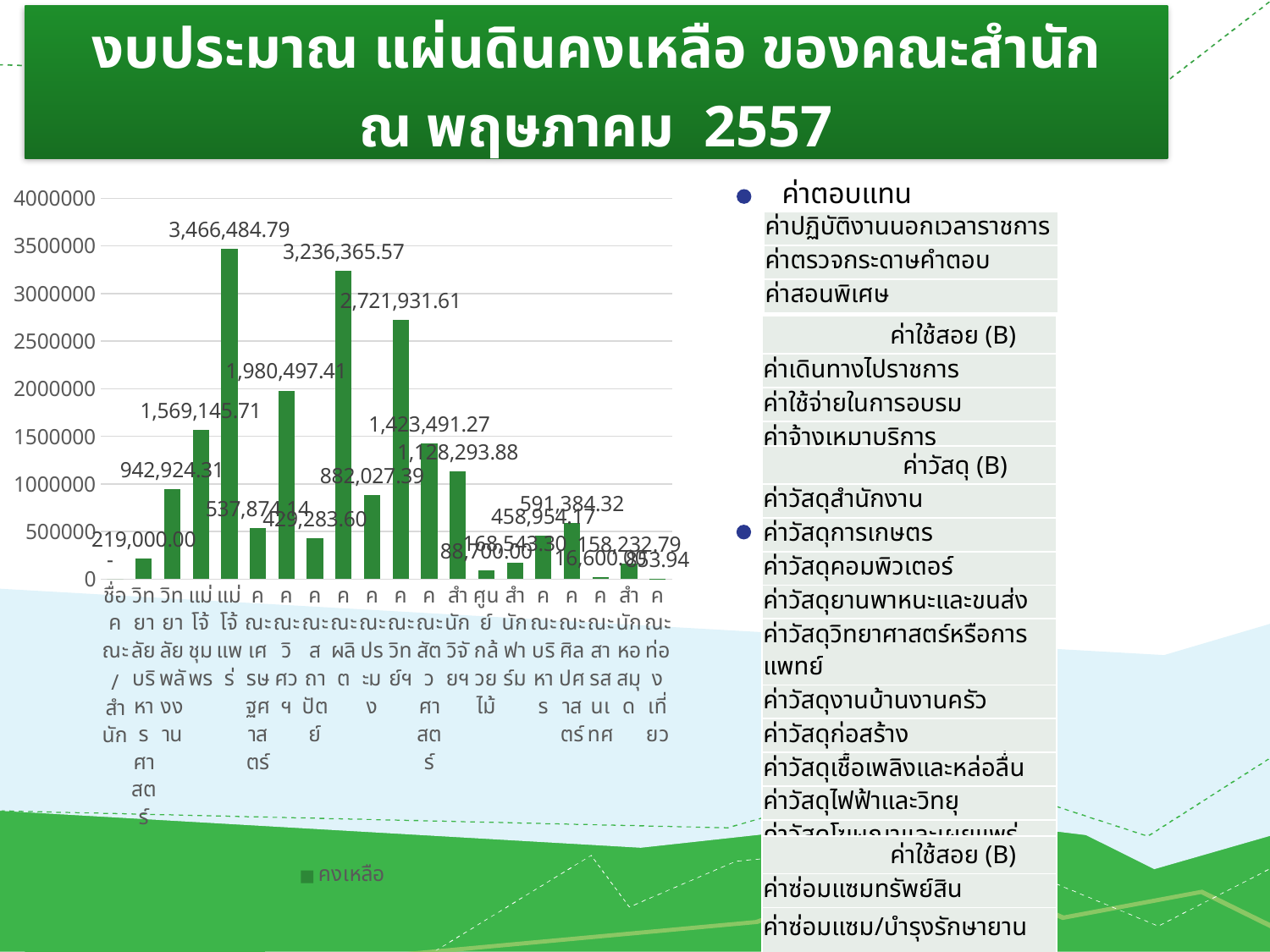
What is the difference between the bar labelled 942,924.31 and the bar labelled 219,000.00? 723,924.31 What type of chart is shown on the slide? bar chart What is the value labelled on the bar for วิทยาลัยพลังงาน? 942,924.31 What is the value labelled on the bar for แม่โจ้ชุมพร? 1,569,145.71 What is the highest value labelled on any bar in the chart? 3,466,484.79 What is the legend entry for the series in the chart? คงเหลือ Is the value for วิทยาลัยพลังงาน greater or less than 1000000? less What is the difference between the two highest bar values, 3,466,484.79 and 3,236,365.57? 230,119.22 What is the highest tick value shown on the vertical axis of the chart? 4000000 Which category has the tallest bar in the chart? แม่โจ้แพร่ Which is larger: the bar labelled 1,980,497.41 or the bar labelled 1,569,145.71? 1,980,497.41 How many series does the chart legend list? 1